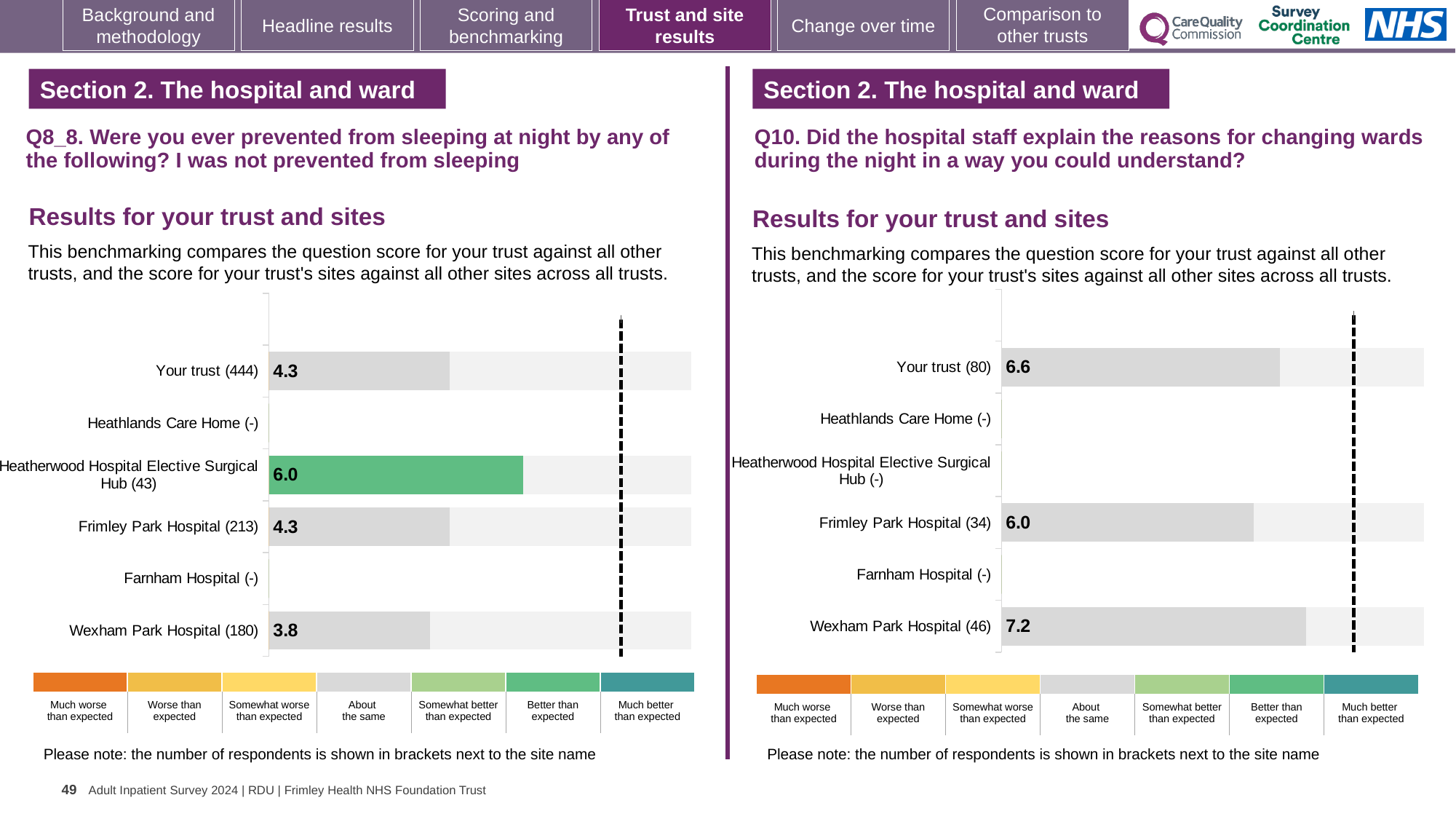
What kind of chart is used on the left for Q8_8? bar chart In the Q10 chart on the right, what is the score for Your trust (80)? 6.6 In the Q10 chart on the right, is the score for Wexham Park Hospital (46) larger or smaller than the score for Your trust (80)? larger In the Q8_8 chart on the left, which site has the lowest score among those with a plotted bar? Wexham Park Hospital (180) In the Q8_8 chart on the left, what is the difference between the scores for Heatherwood Hospital Elective Surgical Hub (43) and Frimley Park Hospital (213)? 1.7 In the Q10 chart on the right, what is the score for Wexham Park Hospital (46)? 7.2 In the Q8_8 chart on the left, what is the score for Heatherwood Hospital Elective Surgical Hub (43)? 6.0 In the Q10 chart on the right, which site has the highest score? Wexham Park Hospital (46) In the Q8_8 chart on the left, what is the score for Your trust (444)? 4.3 In the Q8_8 chart on the left, which site has the highest score? Heatherwood Hospital Elective Surgical Hub (43) In the Q10 chart on the right, what is the score for Frimley Park Hospital (34)? 6.0 In the Q8_8 chart on the left, what is the score for Wexham Park Hospital (180)? 3.8